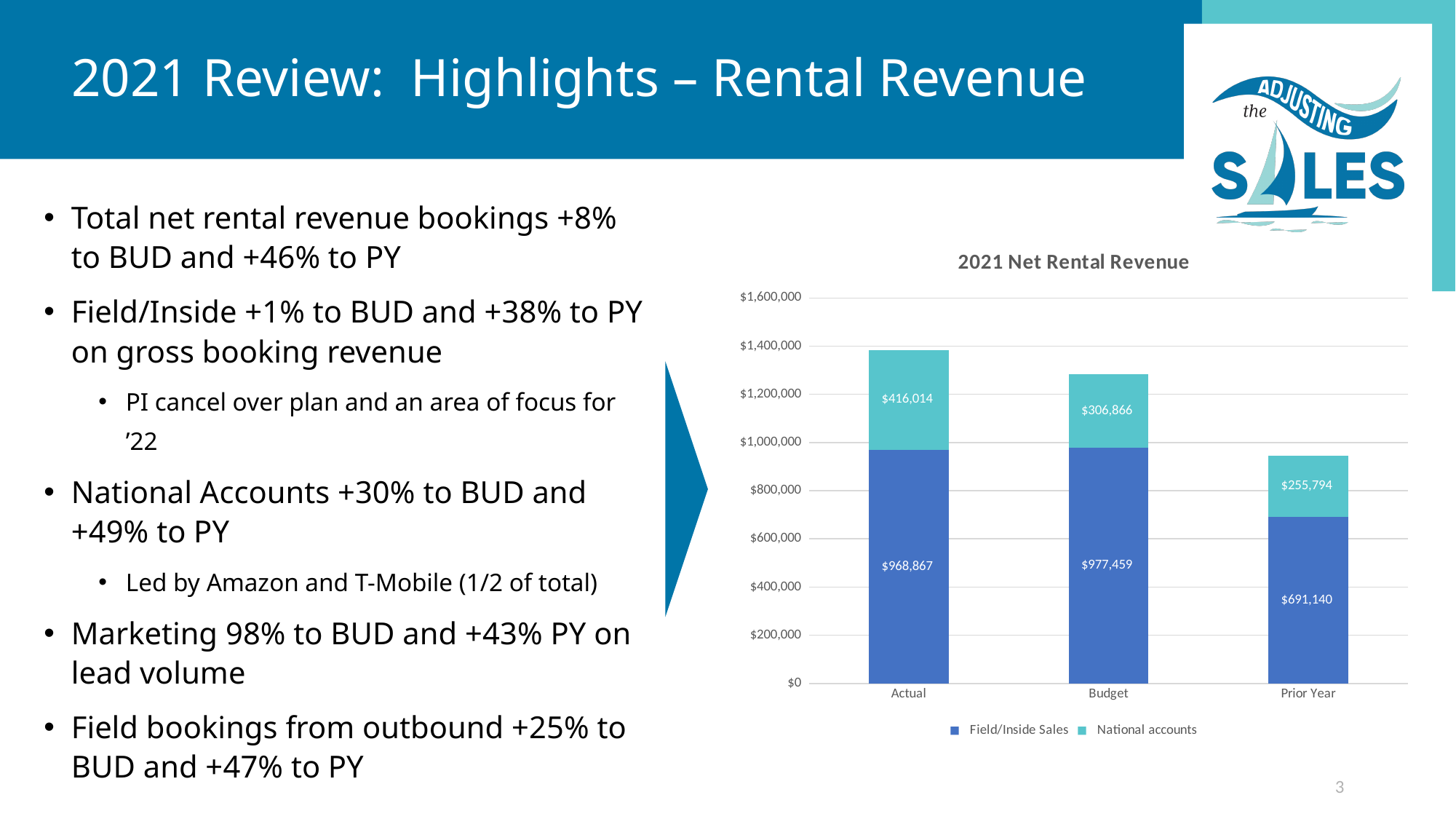
What is the difference between the National accounts values for Actual and Budget? $109,148 What is the National accounts value for Budget? $306,866 What is the Field/Inside Sales value for Prior Year? $691,140 What kind of chart is shown on the slide? Stacked bar chart Is the total for Prior Year greater or less than $1,000,000? less What is the total of the stacked bar for Actual? $1,384,881 What is the title of the chart? 2021 Net Rental Revenue Which category has the lowest Field/Inside Sales value? Prior Year What is the Field/Inside Sales value for Actual? $968,867 How many series does the chart legend list? 2 Which category has the highest National accounts value? Actual How many categories are shown on the x axis of the chart? 3